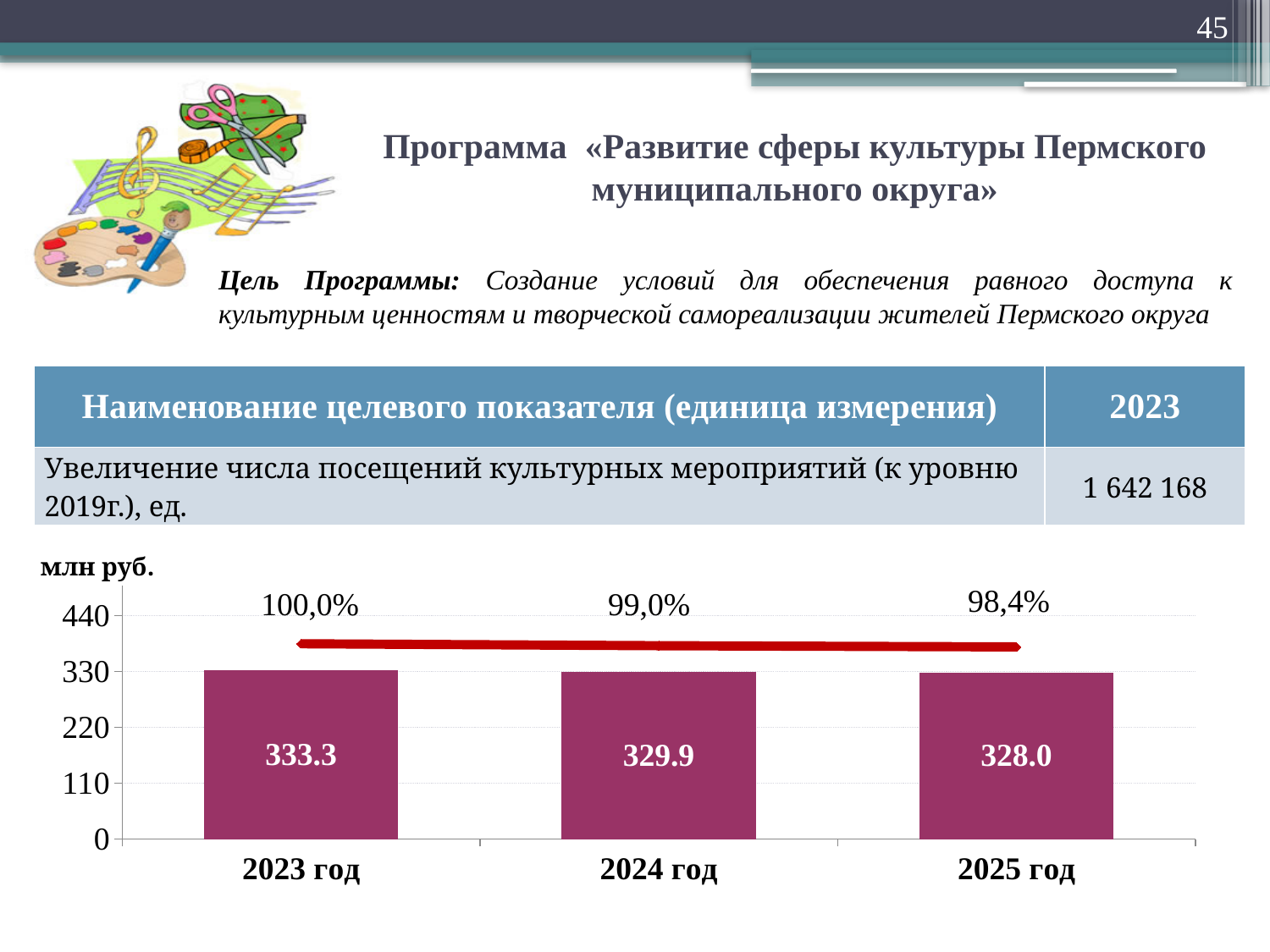
Which year has the lowest value in the bar chart? 2025 год Which is larger, the value for 2024 год or the value for 2025 год? 2024 год What is the difference between the values for 2023 год and 2025 год? 5.3 Which year has the highest value in the bar chart? 2023 год What is the difference between the values for 2023 год and 2024 год? 3.4 How many years (categories) are shown in the bar chart? 3 What is the value for 2023 год in the bar chart? 333.3 What is the value for 2024 год in the bar chart? 329.9 Do the bar values rise or fall from 2023 год to 2025 год? fall What kind of chart is shown on the slide? combination bar and line chart What is the value for 2025 год in the bar chart? 328.0 What percentage label is shown above the 2025 год bar? 98,4%